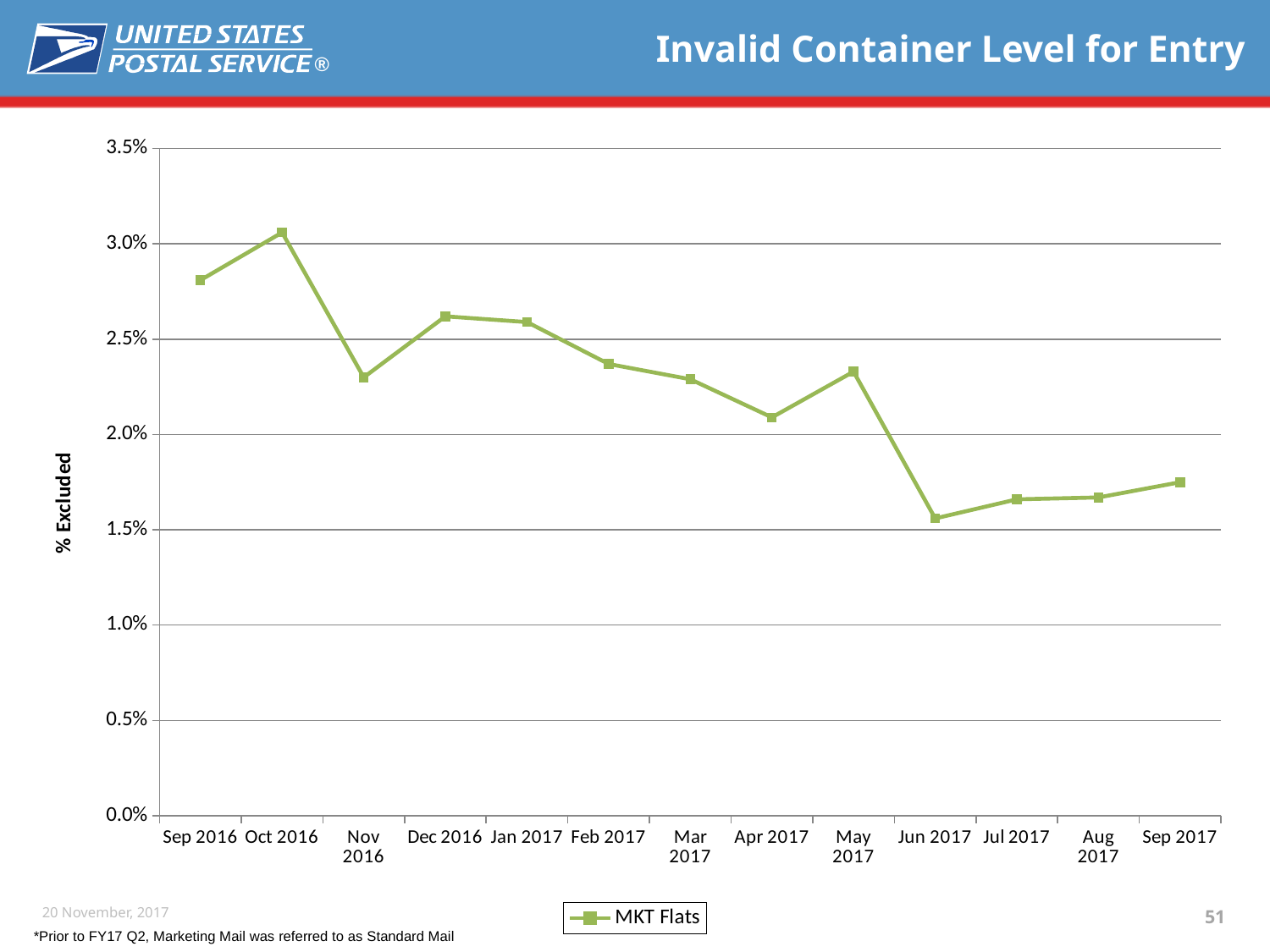
How many series does the legend list? 1 What kind of chart is shown on the slide? Line chart How many monthly data points are plotted on the chart? 13 Is the value for Nov 2016 greater or less than 2.5%? less Is the value for Sep 2017 greater or less than 2.0%? less Is the value for Jun 2017 greater or less than 1.5%? greater Which is larger, the value for May 2017 or the value for Jun 2017? May 2017 What is the label on the vertical axis of the chart? % Excluded Which month has the lowest % Excluded value? Jun 2017 Overall, do the values rise or fall from Sep 2016 to Sep 2017? Fall Which month has the highest % Excluded value? Oct 2016